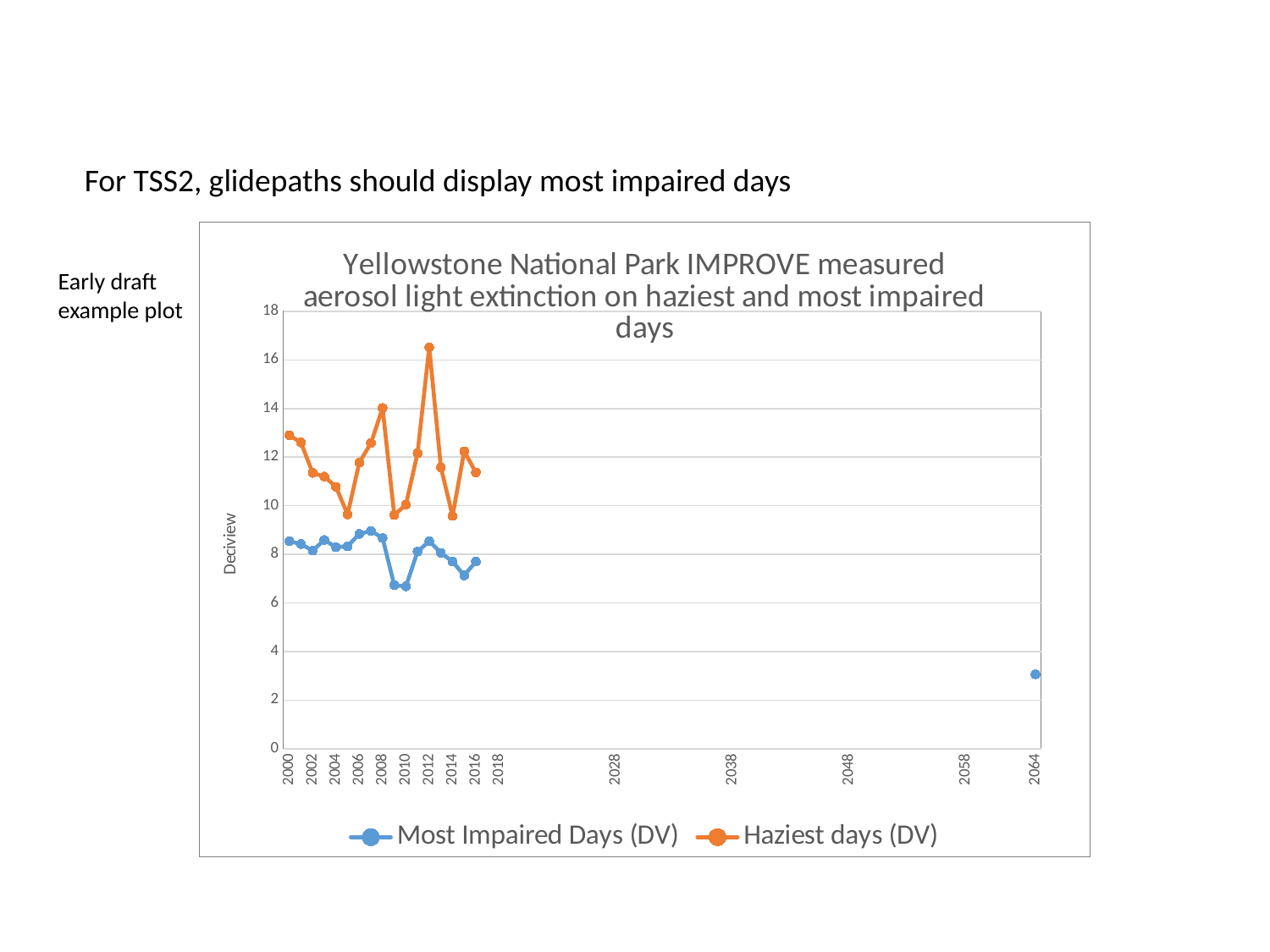
Which series has the higher value in 2012, Most Impaired Days (DV) or Haziest days (DV)? Haziest days (DV) What is the label on the vertical axis of the chart? Deciview Is the Haziest days (DV) value for 2005 greater or less than 10? less Which is larger, the Haziest days (DV) value for 2012 or for 2008? 2012 Which series is drawn in orange? Haziest days (DV) Is the Most Impaired Days (DV) value for 2064 greater or less than 4? less What kind of chart is shown on the slide? line chart Is the Most Impaired Days (DV) value for 2009 greater or less than 8? less How many series does the chart legend list? 2 Does the Haziest days (DV) series rise or fall from 2000 to 2005? fall In which year does the Haziest days (DV) series reach its highest value? 2012